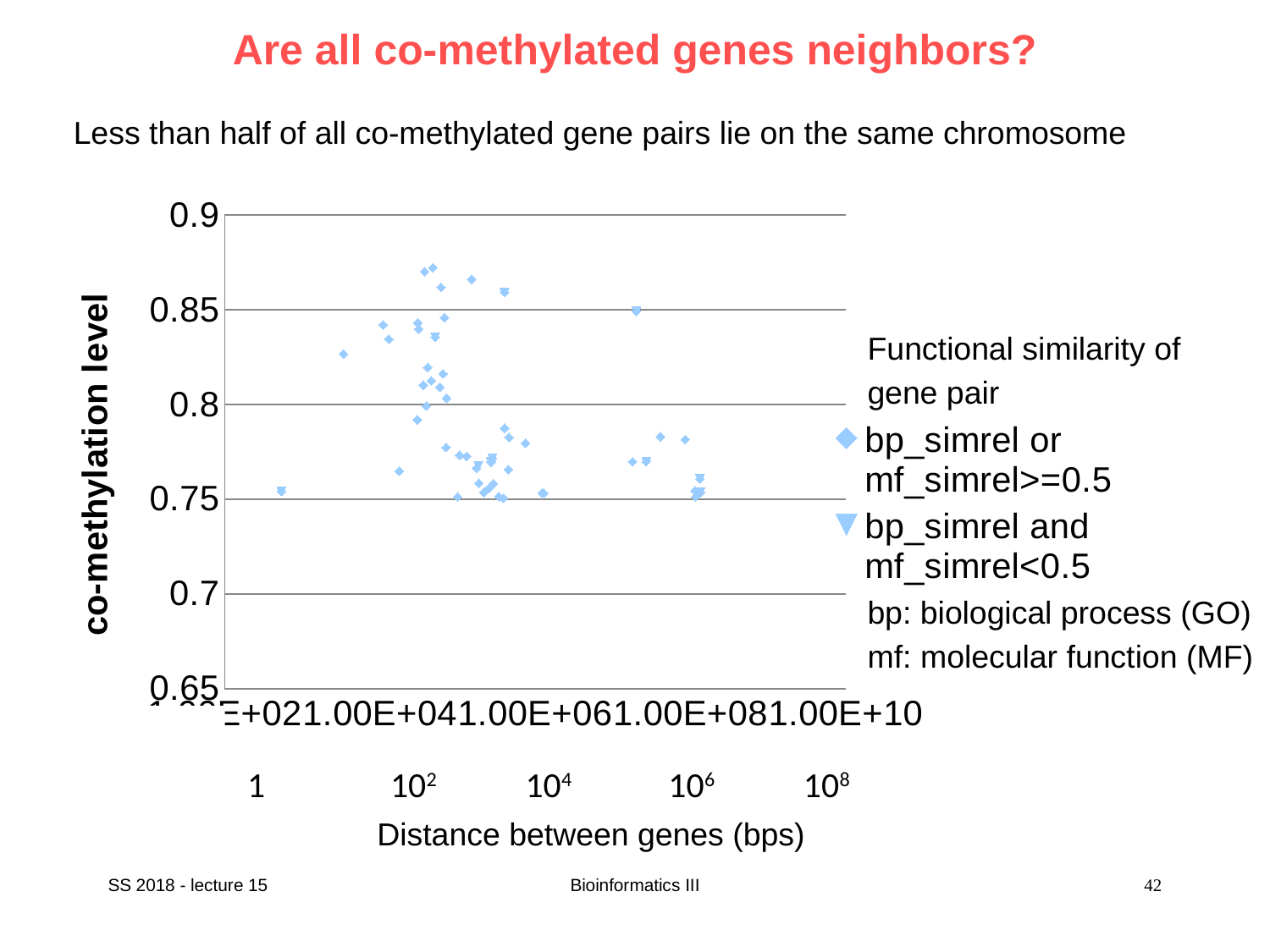
Is the highest co-methylation level plotted on the chart greater or less than 0.85? greater What is the title of the x axis of the chart? Distance between genes (bps) Is the co-methylation level of the point plotted at a distance of about 10 bps greater or less than 0.8? less What kind of chart is shown on the slide? scatter plot Which series contains the point with the highest co-methylation level? bp_simrel or mf_simrel>=0.5 How many series does the chart legend list? 2 What is the title of the y axis of the chart? co-methylation level Is the lowest co-methylation level plotted on the chart greater or less than 0.7? greater